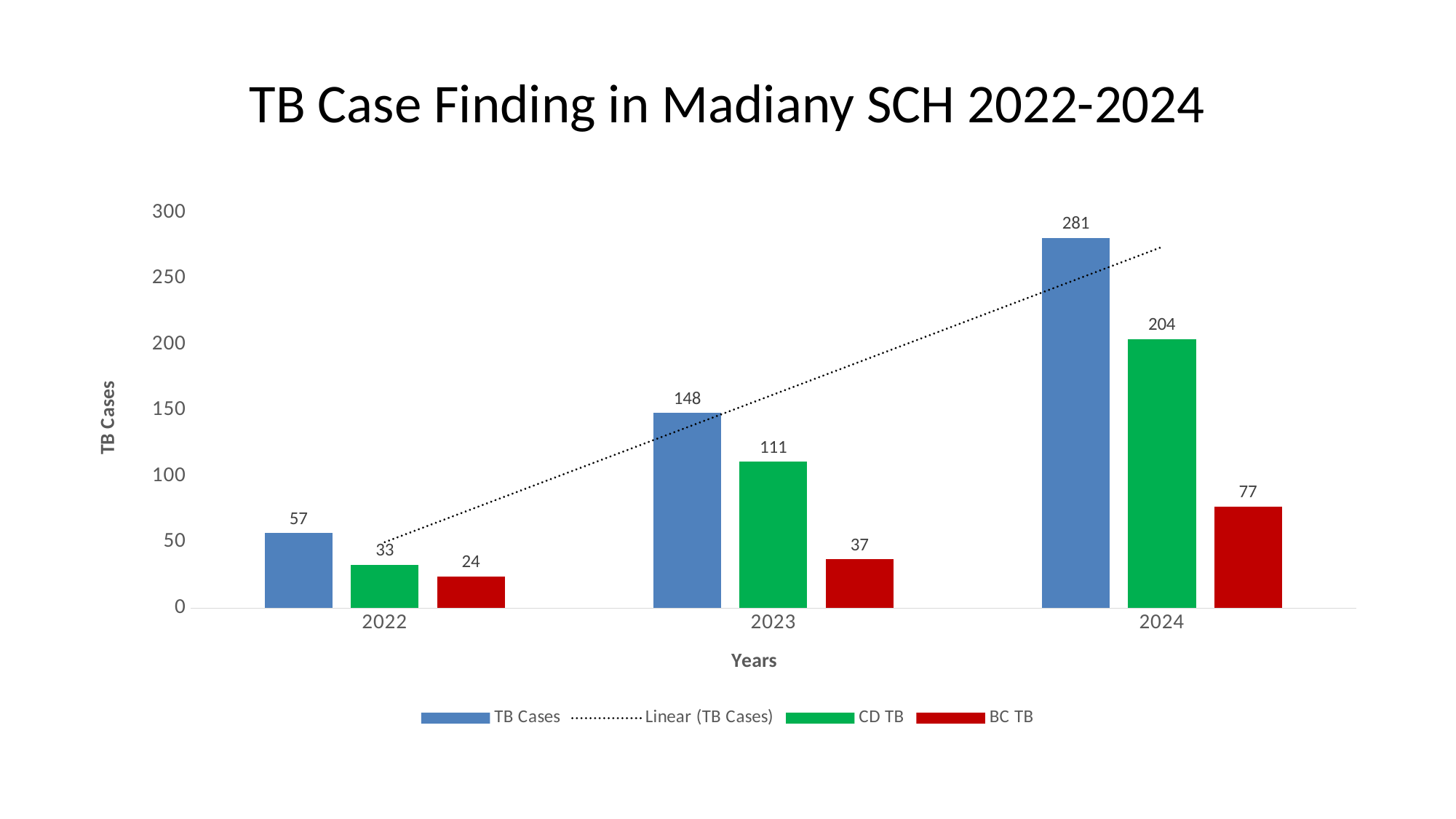
How many entries does the legend list? 4 Do the TB Cases values rise or fall from 2022 to 2024? Rise What is the value of BC TB in 2022? 24 In which year is the BC TB value lowest? 2022 In which year is the TB Cases value highest? 2024 What is the value of CD TB in 2024? 204 How many years are shown on the x axis? 3 What is the title of the chart? TB Case Finding in Madiany SCH 2022-2024 Which is larger in 2023: CD TB or BC TB? CD TB What kind of chart is shown on the slide? Bar chart What is the difference between TB Cases in 2024 and TB Cases in 2022? 224 What is the value of TB Cases in 2023? 148